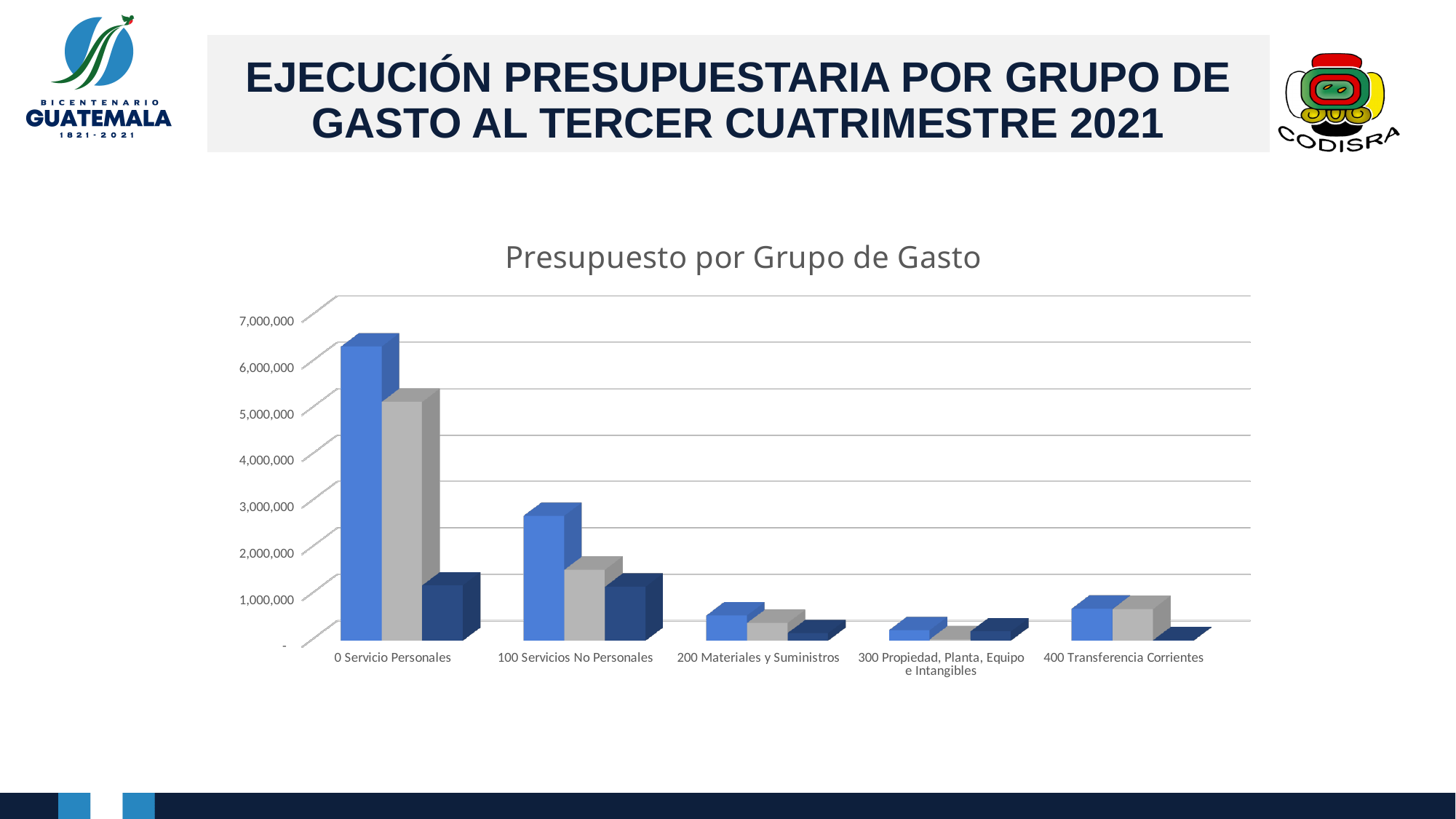
How many bars are plotted for each category? 3 Is the blue bar for 0 Servicio Personales greater or less than 5,000,000? greater Which category has the tallest blue bar? 0 Servicio Personales Which has the larger blue bar: 100 Servicios No Personales or 200 Materiales y Suministros? 100 Servicios No Personales How many expense group categories are shown on the x axis? 5 Is the blue bar for 100 Servicios No Personales greater or less than 3,000,000? less Which category has the shortest blue bar? 300 Propiedad, Planta, Equipo e Intangibles For 0 Servicio Personales, which is larger: the blue bar or the gray bar? the blue bar What kind of chart is shown on the slide? bar chart Is the blue bar for 400 Transferencia Corrientes greater or less than 1,000,000? less What is the title of the chart? Presupuesto por Grupo de Gasto